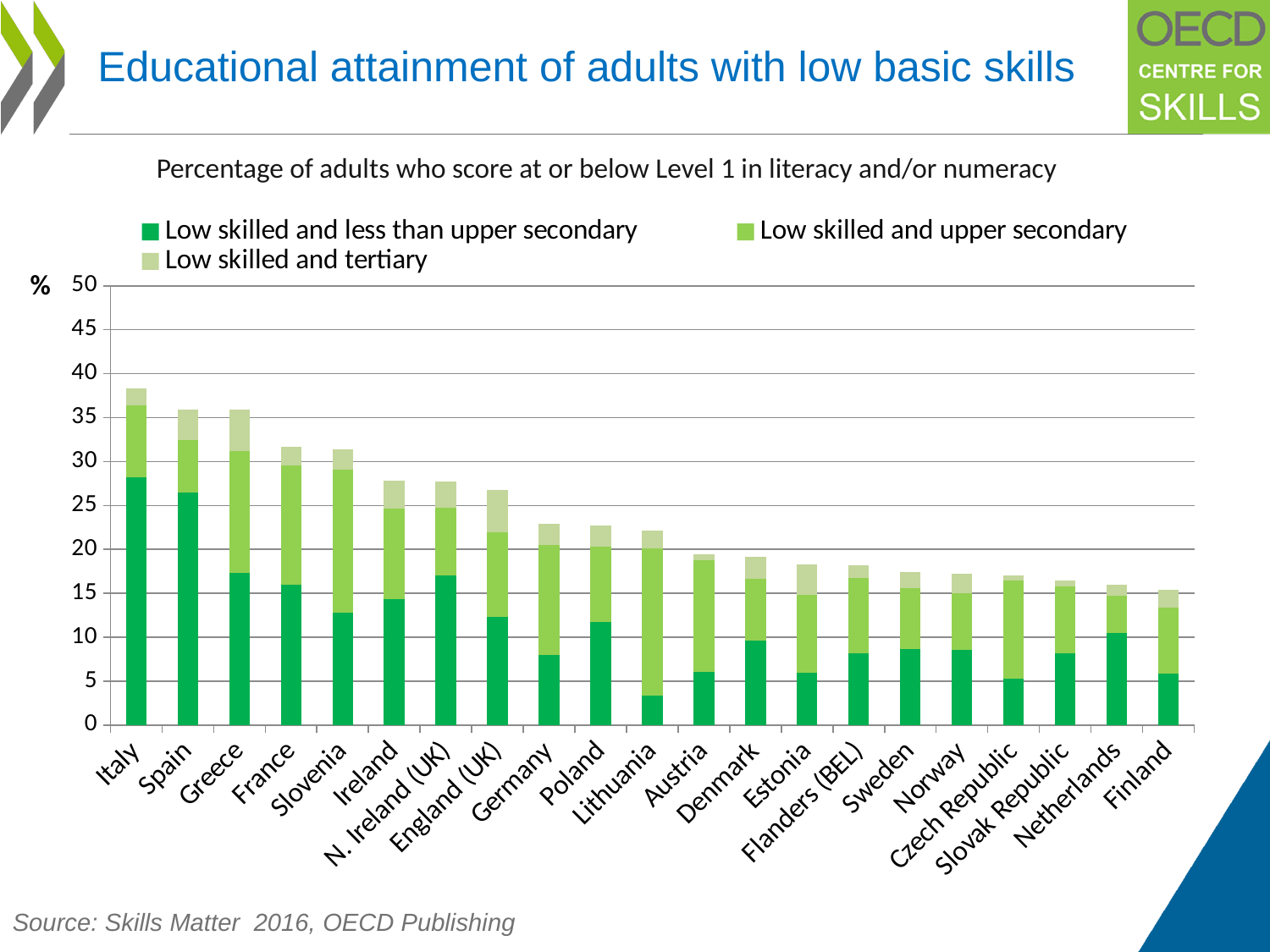
Which is larger, the 'Low skilled and less than upper secondary' value for Spain or for Greece? Spain Do the total bar heights rise or fall moving from left to right along the x axis? Fall Which country has the lowest total percentage of adults with low basic skills? Finland How many series does the chart's legend list? 3 Is the 'Low skilled and less than upper secondary' value for Lithuania greater or less than 5? less Is the total value for Germany greater or less than 25? less How many countries or regions are shown on the x axis of the chart? 21 Is the total value for France greater or less than 30? greater Which country has the highest total percentage of adults with low basic skills? Italy What kind of chart is shown on the slide? Stacked bar chart What is the subtitle printed above the chart's legend? Percentage of adults who score at or below Level 1 in literacy and/or numeracy